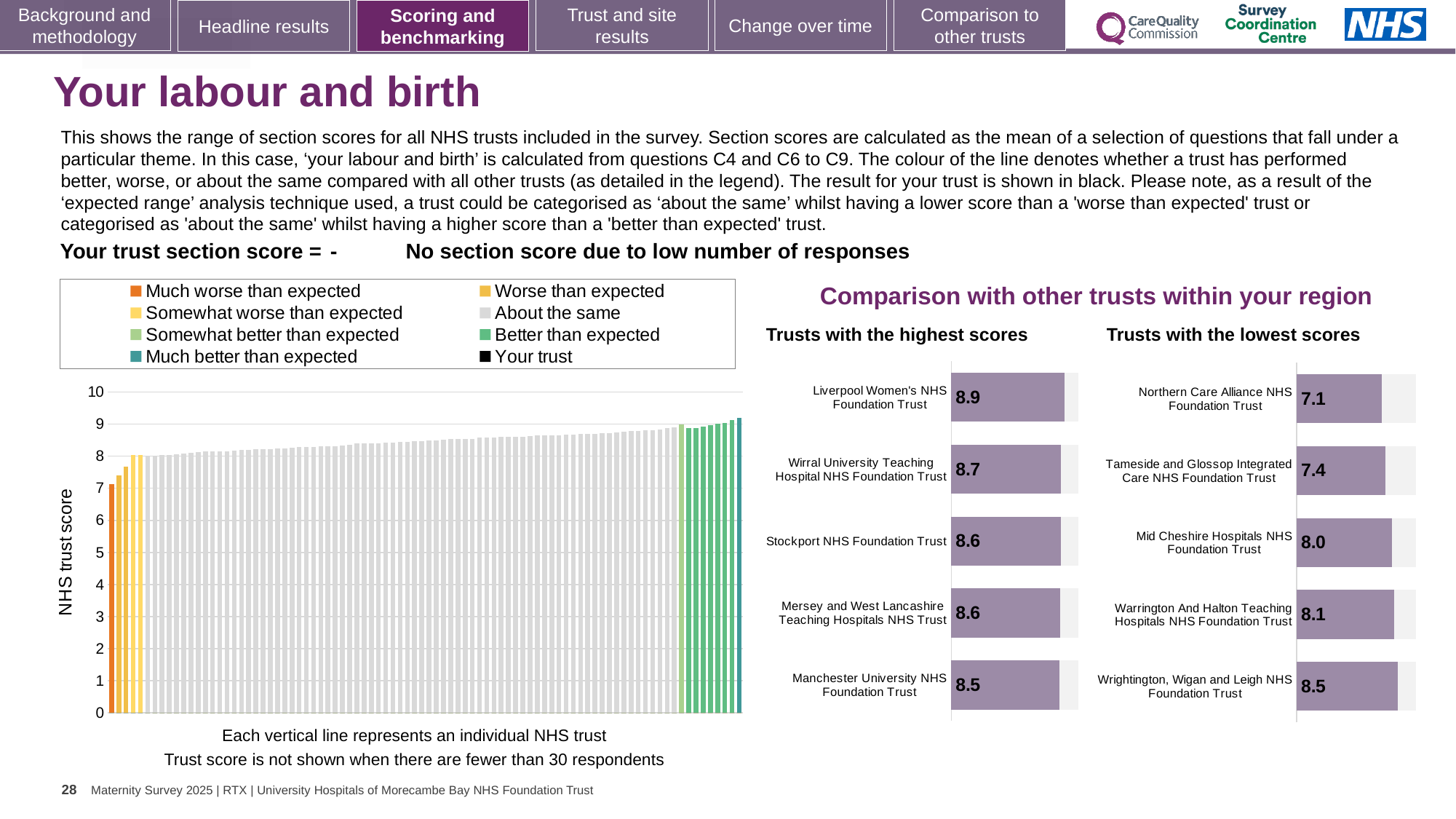
What kind of chart is the large chart on the left showing NHS trust scores? Bar chart In the large chart on the left showing NHS trust scores, is the value of the leftmost bar greater or less than 8? less In the 'Trusts with the lowest scores' chart, what is the score for Northern Care Alliance NHS Foundation Trust? 7.1 In the 'Trusts with the highest scores' chart, which trust has the highest score? Liverpool Women's NHS Foundation Trust In the 'Trusts with the highest scores' chart, what is the score for Liverpool Women's NHS Foundation Trust? 8.9 In the 'Trusts with the highest scores' chart, which has the larger score: Wirral University Teaching Hospital NHS Foundation Trust or Manchester University NHS Foundation Trust? Wirral University Teaching Hospital NHS Foundation Trust In the 'Trusts with the highest scores' chart, what is the score for Stockport NHS Foundation Trust? 8.6 In the large chart on the left showing NHS trust scores, do the values rise or fall from left to right? Rise In the 'Trusts with the lowest scores' chart, what is the difference between the scores of Wrightington, Wigan and Leigh NHS Foundation Trust and Northern Care Alliance NHS Foundation Trust? 1.4 In the large chart on the left showing NHS trust scores, how many entries does the legend list? 8 In the 'Trusts with the lowest scores' chart, which trust has the lowest score? Northern Care Alliance NHS Foundation Trust In the 'Trusts with the lowest scores' chart, how many trusts are shown? 5